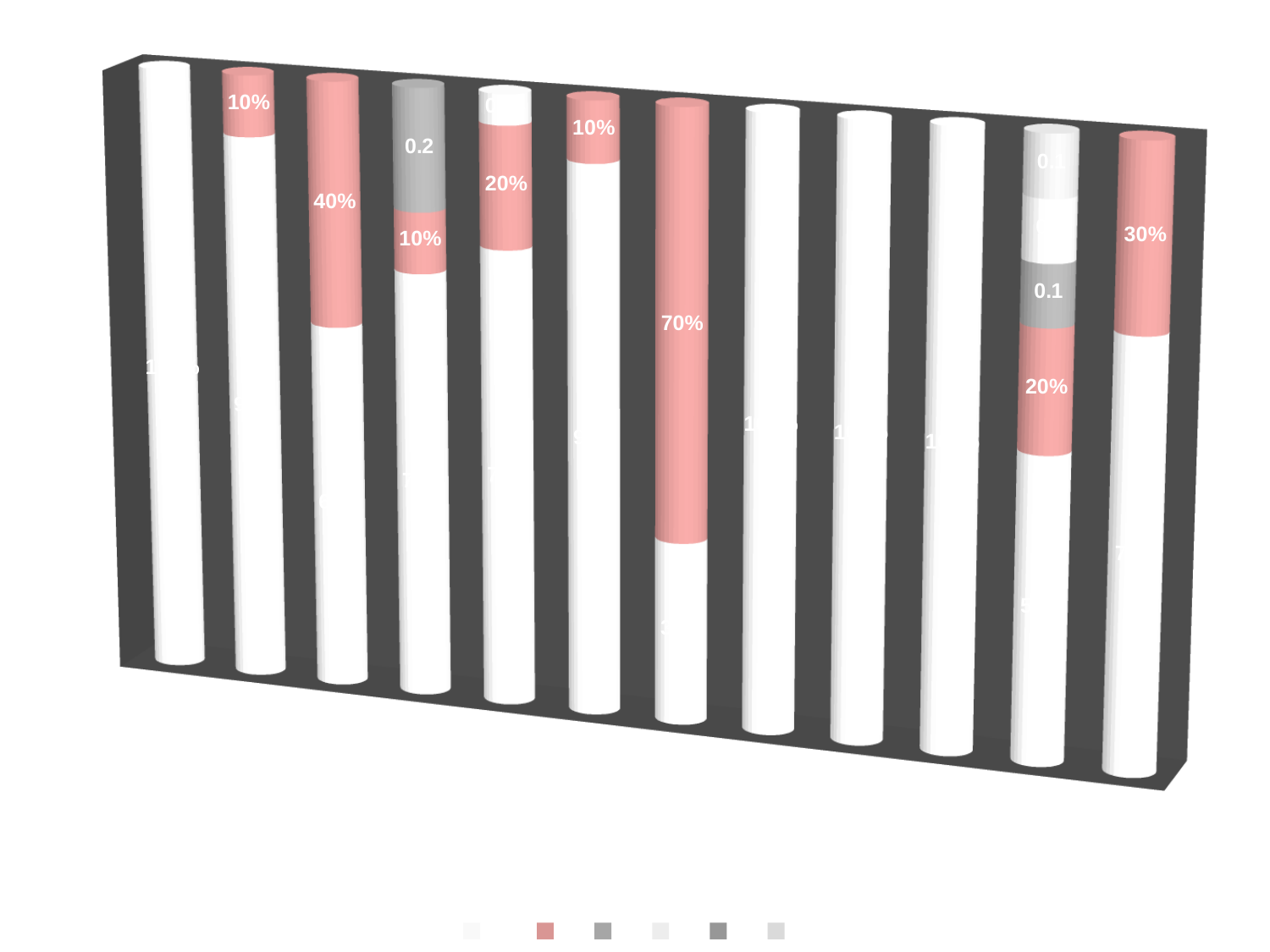
Which is larger: the pink segment of the third bar from the left or the pink segment of the rightmost bar? The third bar from the left What is the value labelled on the pink segment of the seventh bar from the left? 70% What colour is the segment labelled 70%? Pink How many series does the legend list? 6 Which bar has the largest pink segment? The seventh bar from the left What is the value labelled on the pink segment of the third bar from the left? 40% What is the value labelled on the pink segment of the rightmost bar? 30% What is the value labelled on the pink segment of the second bar from the right? 20% How many bars are plotted in the chart? 12 What is the value labelled on the pink segment of the second bar from the left? 10% What kind of chart is shown on the slide? Stacked bar chart What is the difference between the pink segment of the seventh bar from the left (70%) and the pink segment of the rightmost bar (30%)? 40%